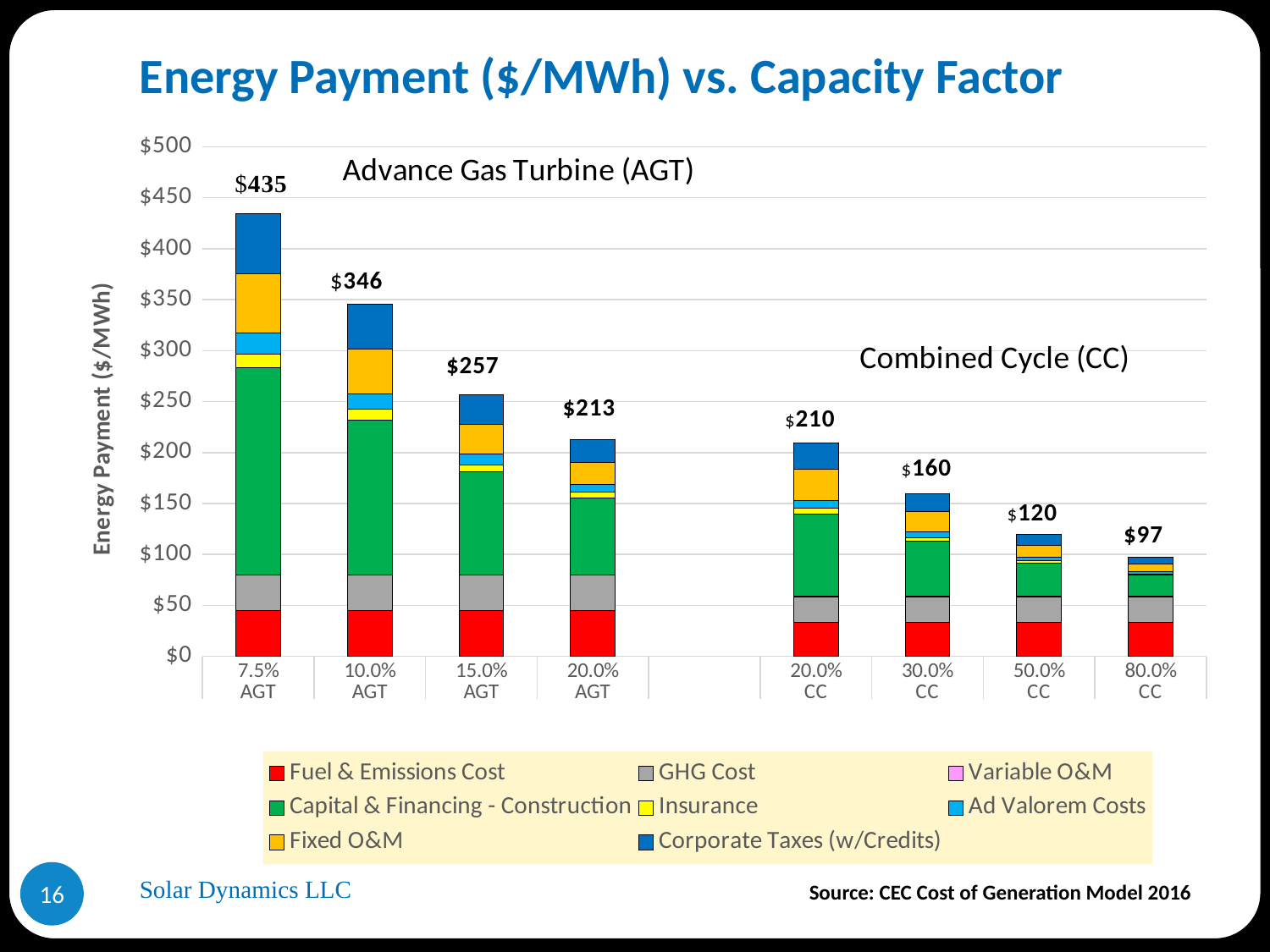
How many series does the legend list? 8 What is the difference between the total for 20.0% CC and the total for 30.0% CC? $50 Which bar has the highest total energy payment? 7.5% AGT What is the difference between the total for 10.0% AGT and the total for 20.0% AGT? $133 Which is larger, the total for 20.0% AGT or the total for 20.0% CC? 20.0% AGT What is the total energy payment for the 80.0% CC bar? $97 What is the total energy payment for the 15.0% AGT bar? $257 What is the total energy payment for the 7.5% AGT bar? $435 What kind of chart is shown on the slide? Stacked bar chart Which bar has the lowest total energy payment? 80.0% CC How many bars are plotted on the chart? 8 Is the Fuel & Emissions Cost segment for 7.5% AGT greater or less than $50? less